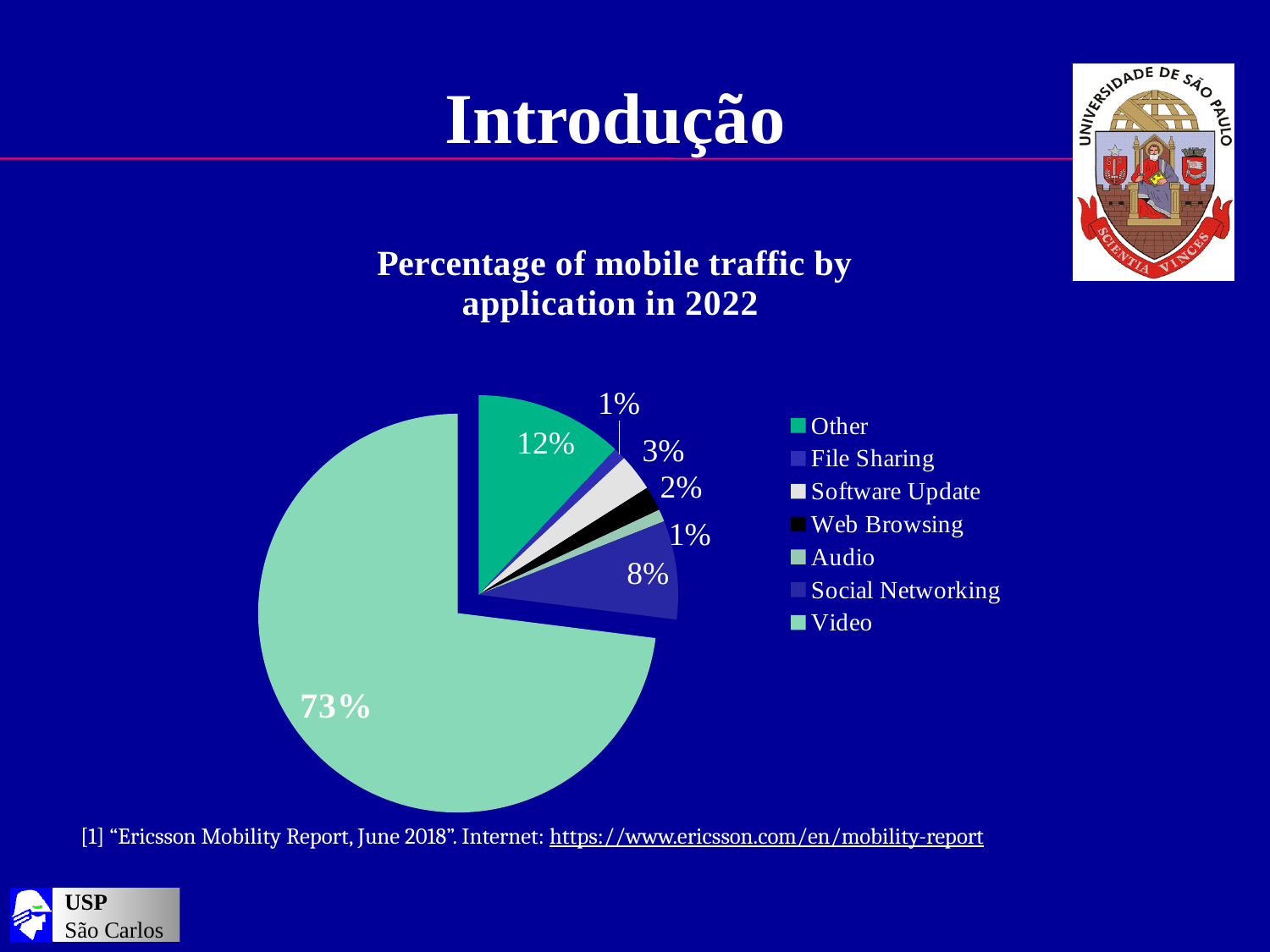
How many entries does the legend list? 7 What percentage is shown for Software Update? 3% What is the difference in percentage points between the Video slice and the Other slice? 61 What is the value shown for the Other slice? 12% What percentage of mobile traffic does Video account for in the pie chart? 73% Which has a larger share, Other or Social Networking? Other What kind of chart is shown on the slide? Pie chart What percentage is shown for Web Browsing? 2% What is the title of the chart? Percentage of mobile traffic by application in 2022 Which application category has the largest share of mobile traffic? Video What percentage is shown for Social Networking? 8% How many categories are shown in the pie chart? 7